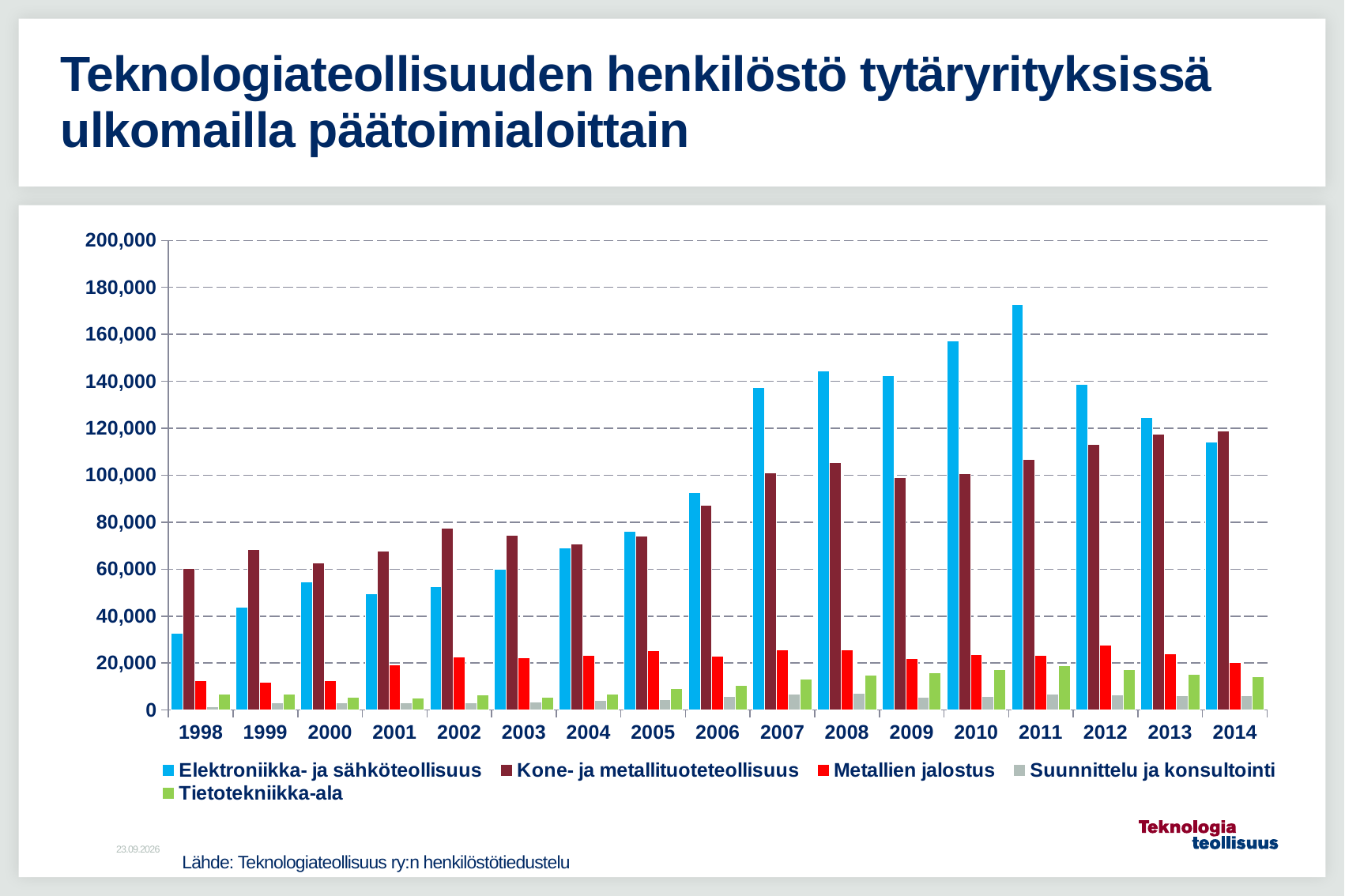
In which year is the value for Elektroniikka- ja sähköteollisuus lowest? 1998 Is the value for Elektroniikka- ja sähköteollisuus in 2011 greater or less than 160,000? greater How many series does the legend list? 5 How many years are shown on the x axis? 17 Is the value for Metallien jalostus in 2012 greater or less than 20,000? greater What kind of chart is shown on the slide? bar chart Which series has the lowest value in 2014? Suunnittelu ja konsultointi In which year is the value for Elektroniikka- ja sähköteollisuus highest? 2011 In 2013, which is larger: Elektroniikka- ja sähköteollisuus or Kone- ja metallituoteteollisuus? Elektroniikka- ja sähköteollisuus Do the values for Elektroniikka- ja sähköteollisuus rise or fall from 2011 to 2014? fall Is the value for Elektroniikka- ja sähköteollisuus in 1998 greater or less than 40,000? less